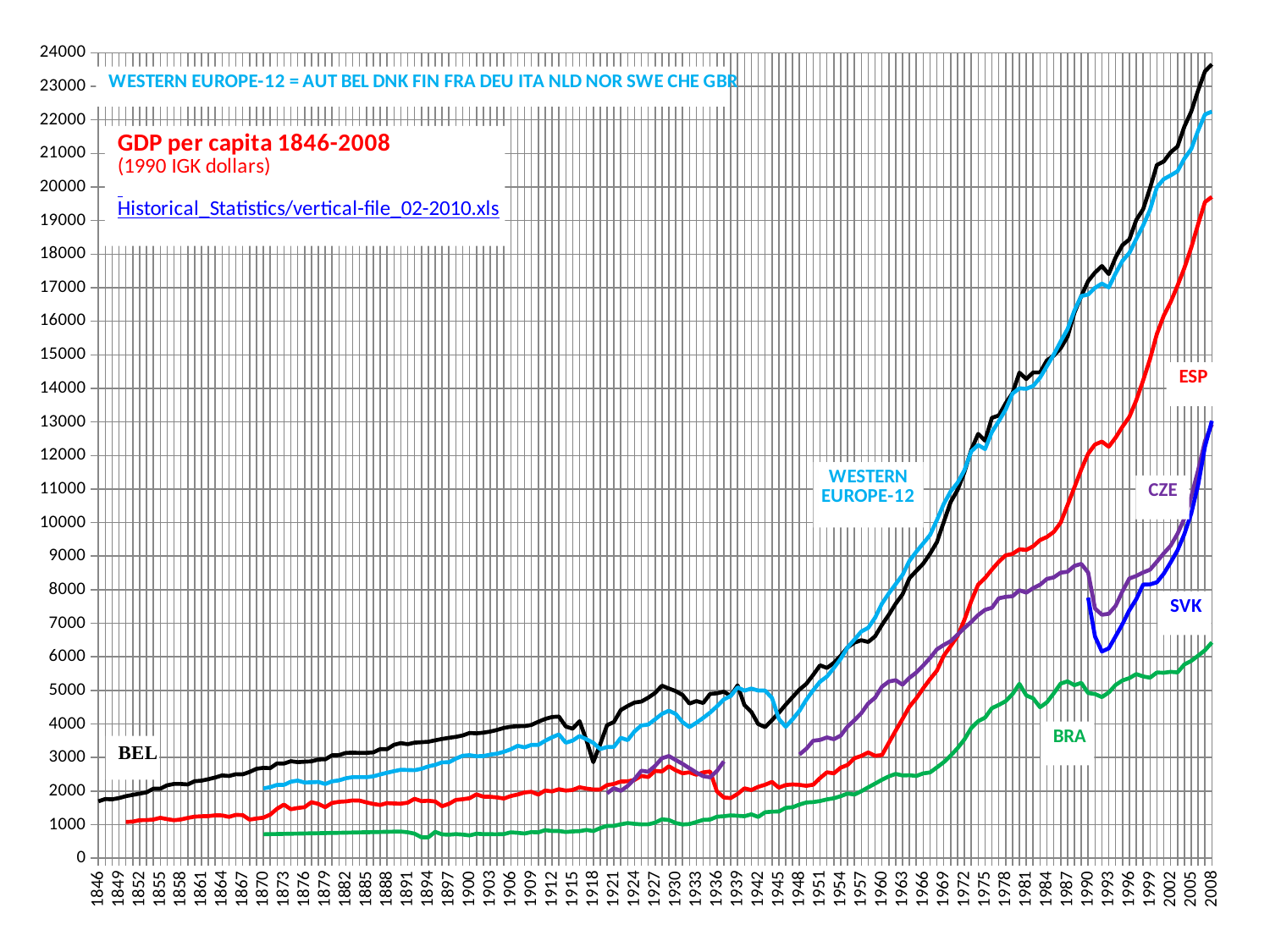
Does the BRA series generally rise or fall from 1870 to 2008? rise What kind of chart is shown on the slide? line chart Is the value for ESP in 2008 greater or less than 20000? less How many series (countries or groups) are plotted on the chart? 6 Is the value for BRA in 2008 greater or less than 5000? greater In 2008, which is higher: BEL or WESTERN EUROPE-12? BEL Which series has the lowest value in 2008? BRA Is the value for BEL in 1846 greater or less than 2000? less What is the title of the chart? GDP per capita 1846-2008 In what units are the GDP per capita values expressed, according to the subtitle? 1990 IGK dollars Which series has the highest value in 2008? BEL